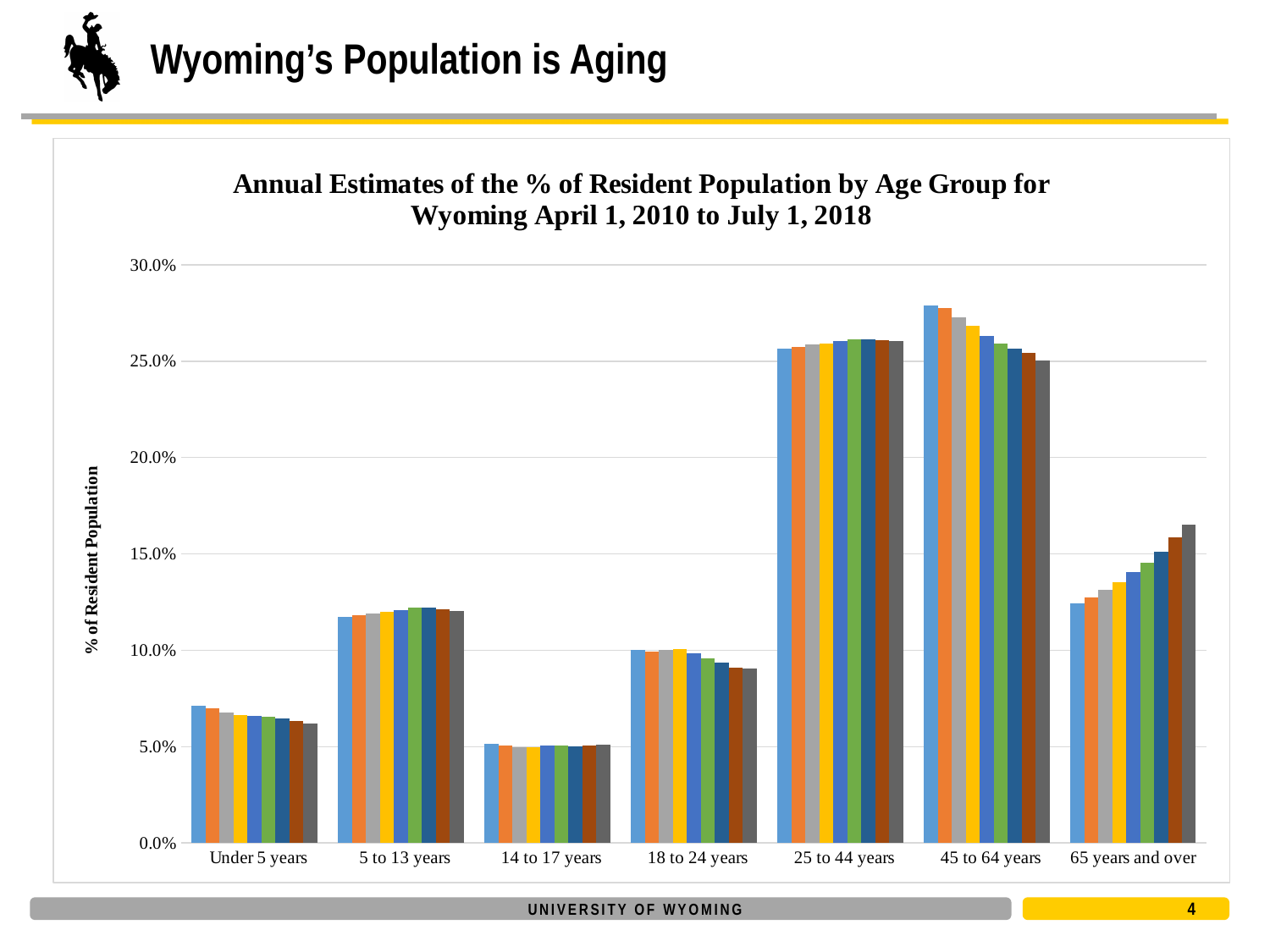
Are the values for 5 to 13 years greater or less than 15.0%? less Which age group has the lowest share of resident population? 14 to 17 years Are the values for 45 to 64 years greater or less than 30.0%? less What is the label on the vertical axis of the chart? % of Resident Population Which age group has larger values, 5 to 13 years or 18 to 24 years? 5 to 13 years Are the values for 65 years and over greater or less than 10.0%? greater Within the Under 5 years group, do the bars rise or fall from left to right across the years? fall How many age group categories are shown on the x axis? 7 What kind of chart is shown on the slide? bar chart Within the 65 years and over group, do the bars rise or fall from left to right across the years? rise